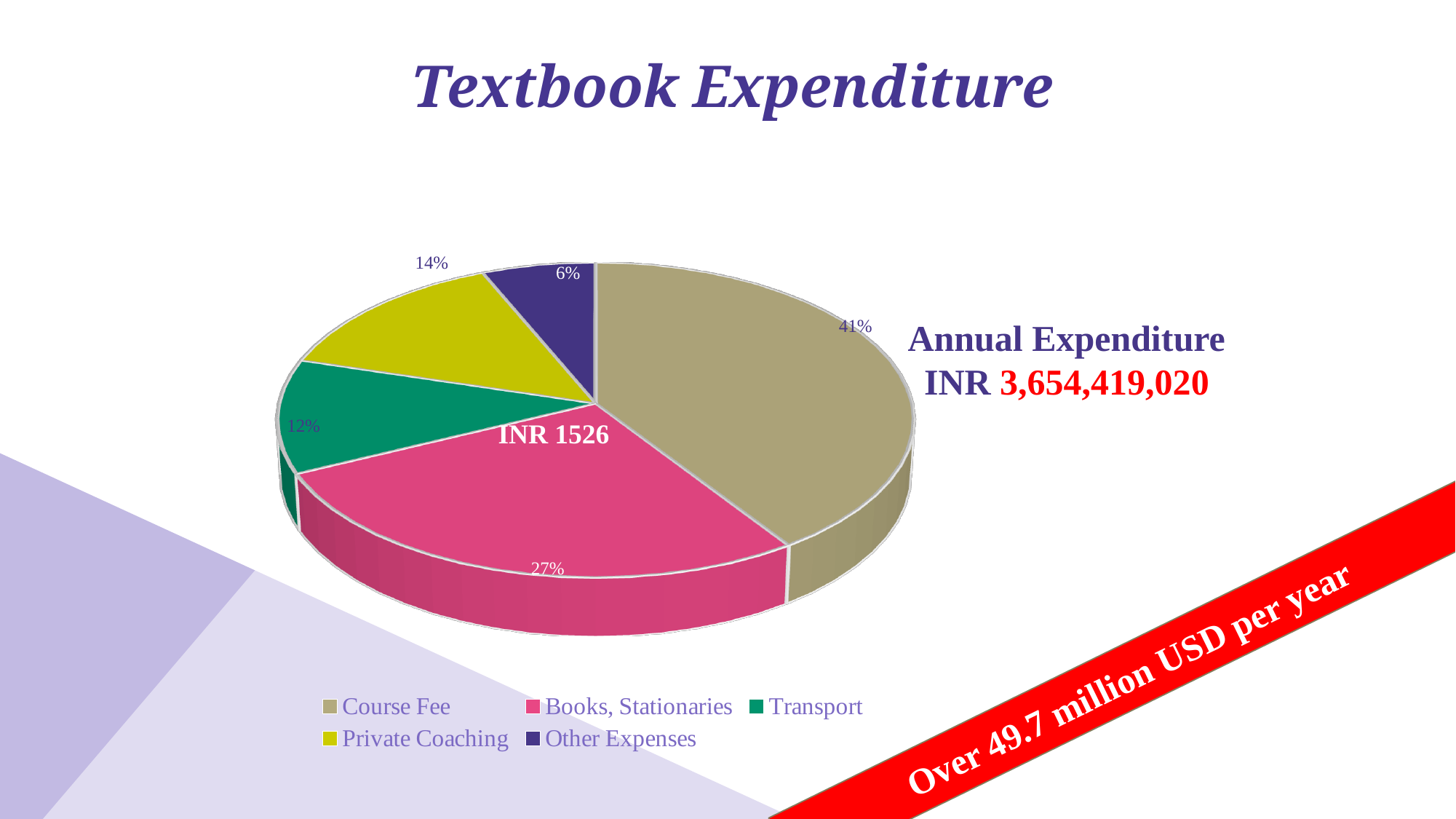
Which is larger, the share for Private Coaching or the share for Transport? Private Coaching How many categories are shown in the pie chart? 5 Which category has the smallest slice of the pie? Other Expenses What share of the pie does Course Fee take? 41% What share of the pie does Other Expenses take? 6% What share of the pie does Private Coaching take? 14% What is the difference in percentage points between Course Fee and Books, Stationaries? 14 What kind of chart is shown on the slide? Pie chart What is the title of the slide containing the pie chart? Textbook Expenditure Which category has the largest slice of the pie? Course Fee